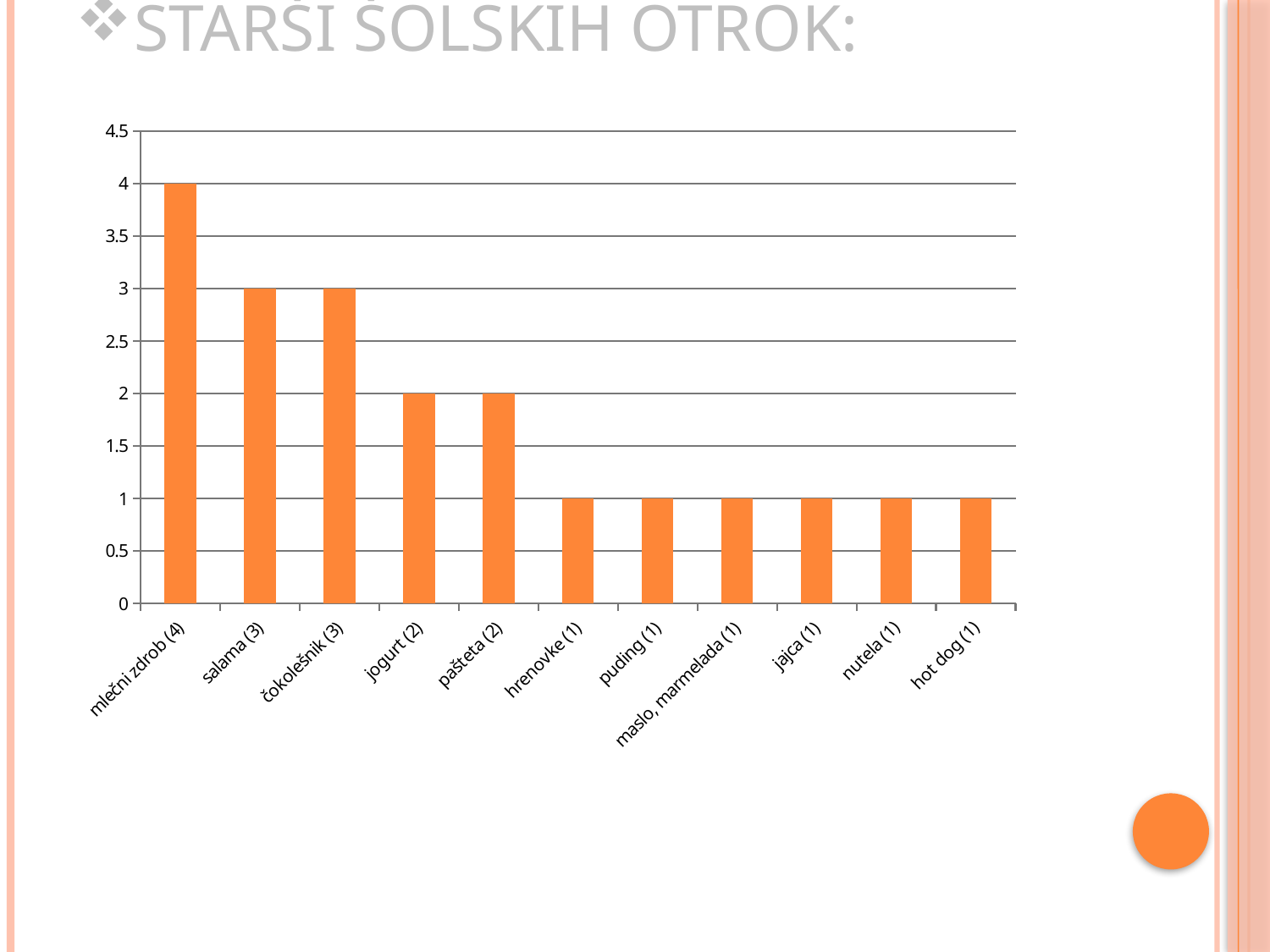
What is the value for hot dog? 1 Do the values generally rise or fall from left to right along the x axis? fall What is the value for jogurt? 2 What is the value for salama? 3 Which category has the highest value in the chart? mlečni zdrob (4) What is the value for mlečni zdrob? 4 What colour are the bars in the chart? orange Which is larger, the value for čokolešnik or the value for hrenovke? čokolešnik What is the difference between the values for mlečni zdrob and pašteta? 2 What kind of chart is shown on the slide? bar chart Is the value for salama greater or less than 2.5? greater How many categories are plotted in the chart? 11